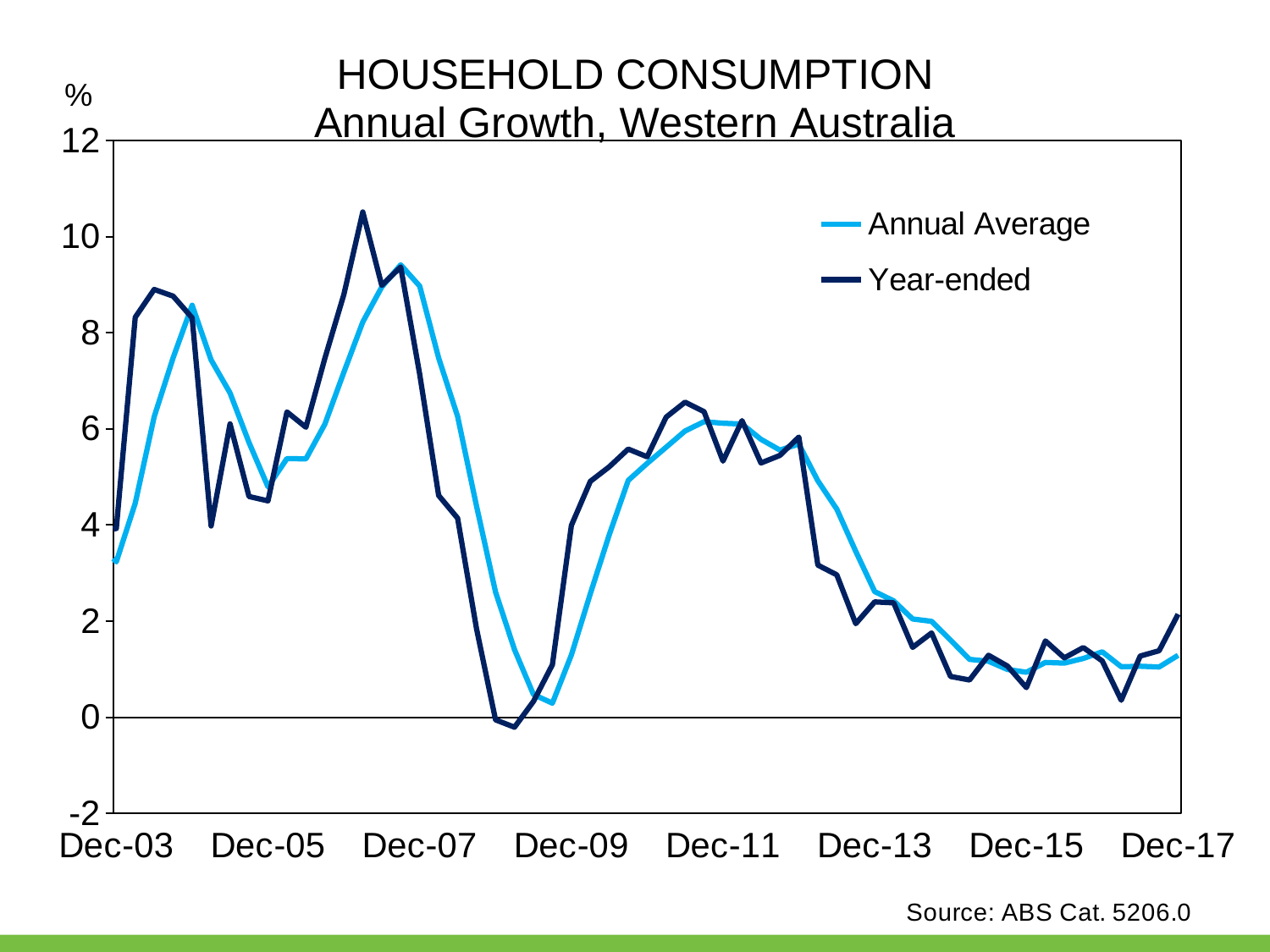
Does the Annual Average series rise or fall between Dec-11 and Dec-15? fall Is the value of the Annual Average series at Dec-17 greater or less than 2? less Is the value of the Annual Average series at Dec-03 greater or less than 4? less Which series falls below 0 on the chart? Year-ended Which series reaches the highest value on the chart? Year-ended Is the value of the Annual Average series at Dec-15 greater or less than 2? less What is the title of the chart? HOUSEHOLD CONSUMPTION Annual Growth, Western Australia How many date labels are shown on the x axis? 8 How many series does the legend list? 2 What kind of chart is shown on the slide? line chart What source is cited below the chart? ABS Cat. 5206.0